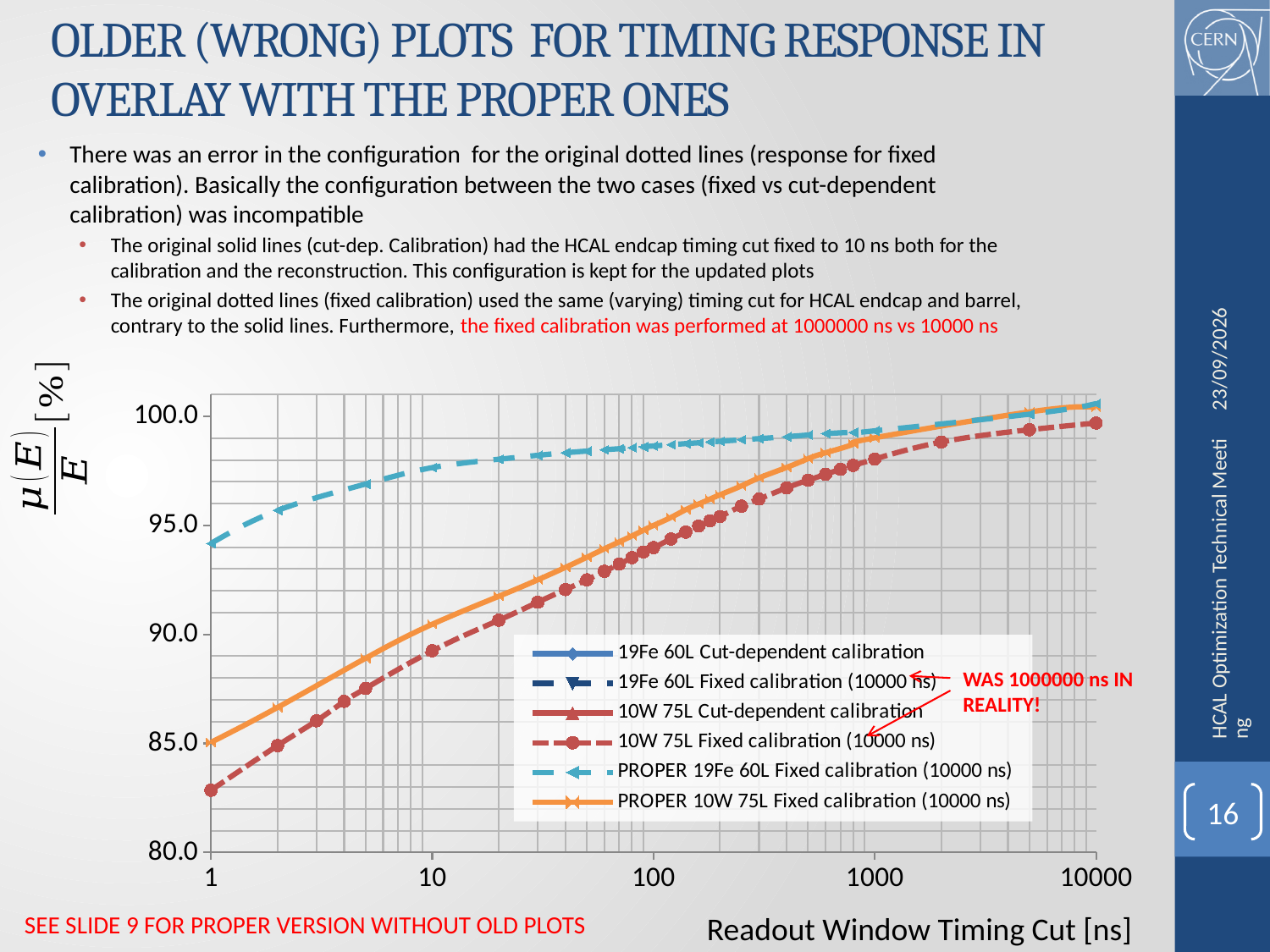
Do the values of the PROPER 10W 75L Fixed calibration (10000 ns) series rise or fall as the timing cut increases along the x axis? rise Is the value of the PROPER 19Fe 60L Fixed calibration (10000 ns) series at a timing cut of 1 ns greater or less than 90.0? greater Is the value of the PROPER 10W 75L Fixed calibration (10000 ns) series at a timing cut of 1000 ns greater or less than 95.0? greater What kind of chart is shown on the slide? line chart At a timing cut of 10 ns, which series has the higher value: PROPER 19Fe 60L Fixed calibration (10000 ns) or PROPER 10W 75L Fixed calibration (10000 ns)? PROPER 19Fe 60L Fixed calibration (10000 ns) How many series does the chart legend list? 6 What is the highest tick value shown on the y-axis of the chart? 100.0 Is the value of the 10W 75L Fixed calibration (10000 ns) series at a timing cut of 1 ns greater or less than 85.0? less Do the values of the 10W 75L Fixed calibration (10000 ns) series rise or fall as the timing cut increases along the x axis? rise What is the x-axis title of the chart? Readout Window Timing Cut [ns] At a timing cut of 1 ns, which series has the higher value: PROPER 19Fe 60L Fixed calibration (10000 ns) or 10W 75L Fixed calibration (10000 ns)? PROPER 19Fe 60L Fixed calibration (10000 ns)